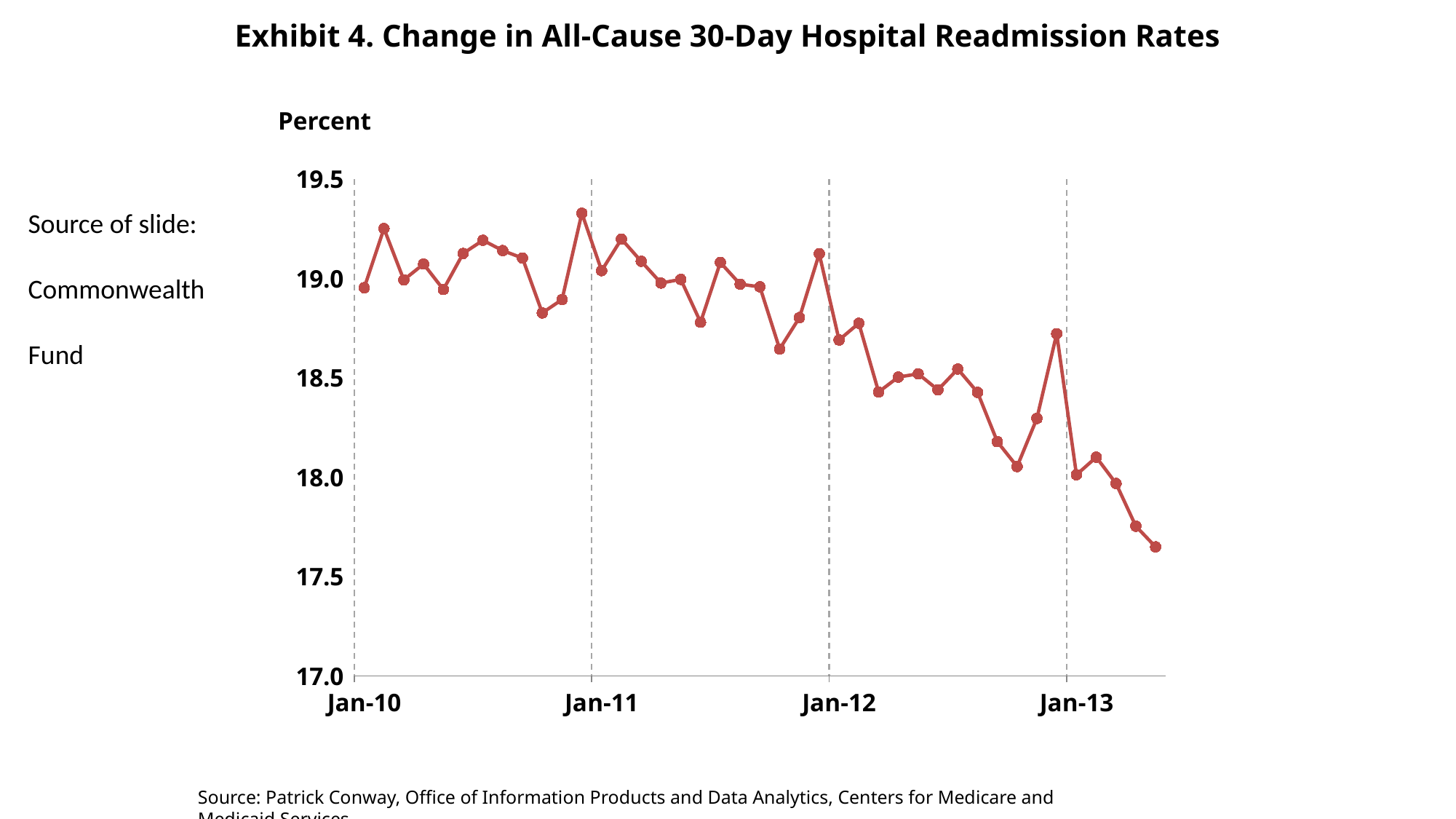
Is the last plotted value (after Jan-13) greater or less than 18.0? less What unit is the y axis labelled with? Percent Which is larger, the value at Jan-10 or the last value in the series? Jan-10 What kind of chart is shown on the slide? line chart Which is larger, the value at Jan-12 or the value at Jan-13? Jan-12 Is the highest point on the line, just before Jan-11, greater or less than 19.0? greater Is the value at Jan-12 greater or less than 18.5? greater In which year does the lowest value on the line occur? 2013 How many year labels are shown on the x axis? 4 Overall, do the readmission rates rise or fall from Jan-10 to the end of the series? fall What is the title of the chart? Exhibit 4. Change in All-Cause 30-Day Hospital Readmission Rates